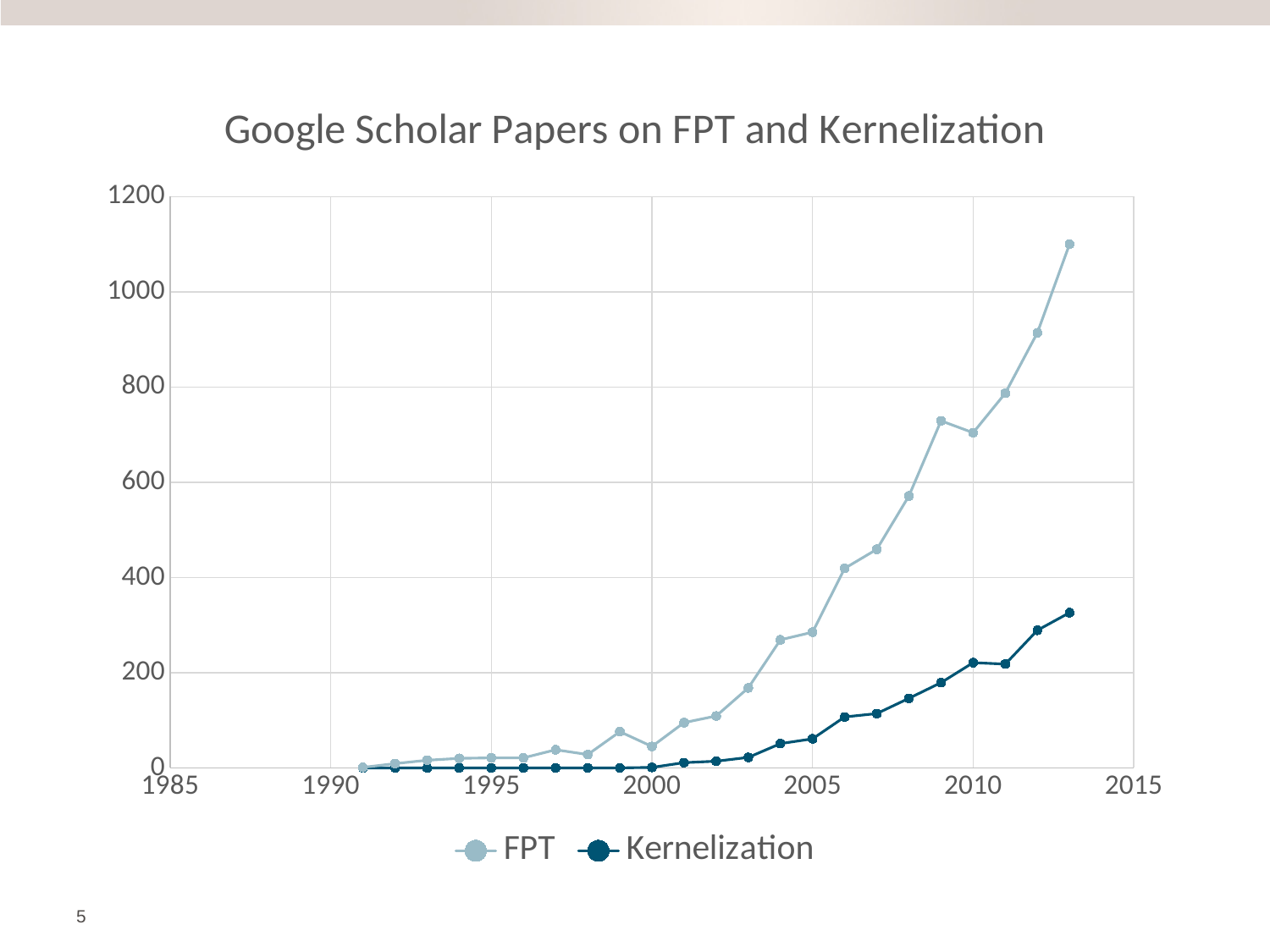
Is the FPT value for 2010 greater or less than 600? greater In 2013, which series has the larger value, FPT or Kernelization? FPT Do the FPT values generally rise or fall from 1991 to 2013? Rise Is the FPT value for 2013 greater or less than 1000? greater Which two series are listed in the legend? FPT and Kernelization What is the title of the chart? Google Scholar Papers on FPT and Kernelization In which year does the FPT series reach its highest value? 2013 Do the Kernelization values generally rise or fall from 2000 to 2013? Rise In which year does the Kernelization series reach its highest value? 2013 What kind of chart is shown on the slide? Line chart Is the Kernelization value for 2013 greater or less than 400? less How many series does the legend list? 2